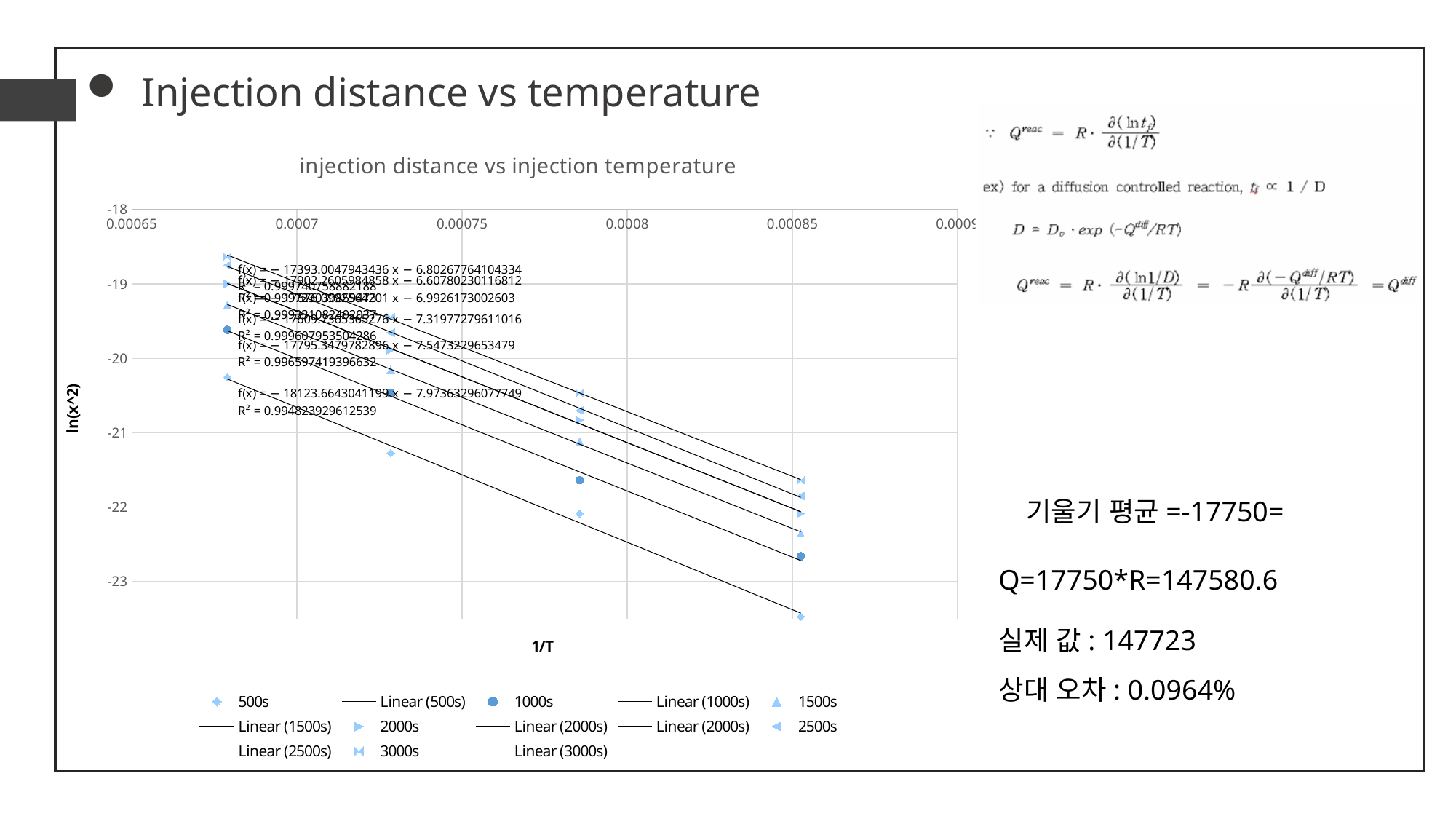
What is the label of the y axis of the chart? ln(x^2) Which series has the lowest ln(x^2) values across the chart? 500s How many data points are plotted for each series? 4 Which series has the highest ln(x^2) values across the chart? 3000s At 1/T = 0.00085, is the value for the 500s series greater or less than -23? less How many data series (excluding the linear trendlines) does the legend list? 6 At 1/T = 0.00085, which series has the larger ln(x^2) value, 3000s or 500s? 3000s What kind of chart is shown on the slide? scatter chart Do the plotted values rise or fall as 1/T increases along the x axis? fall What is the title of the chart? injection distance vs injection temperature At the leftmost data points (around 1/T = 0.00068), is the value for the 500s series greater or less than -20? less At 1/T = 0.00085, is the value for the 3000s series greater or less than -22? greater